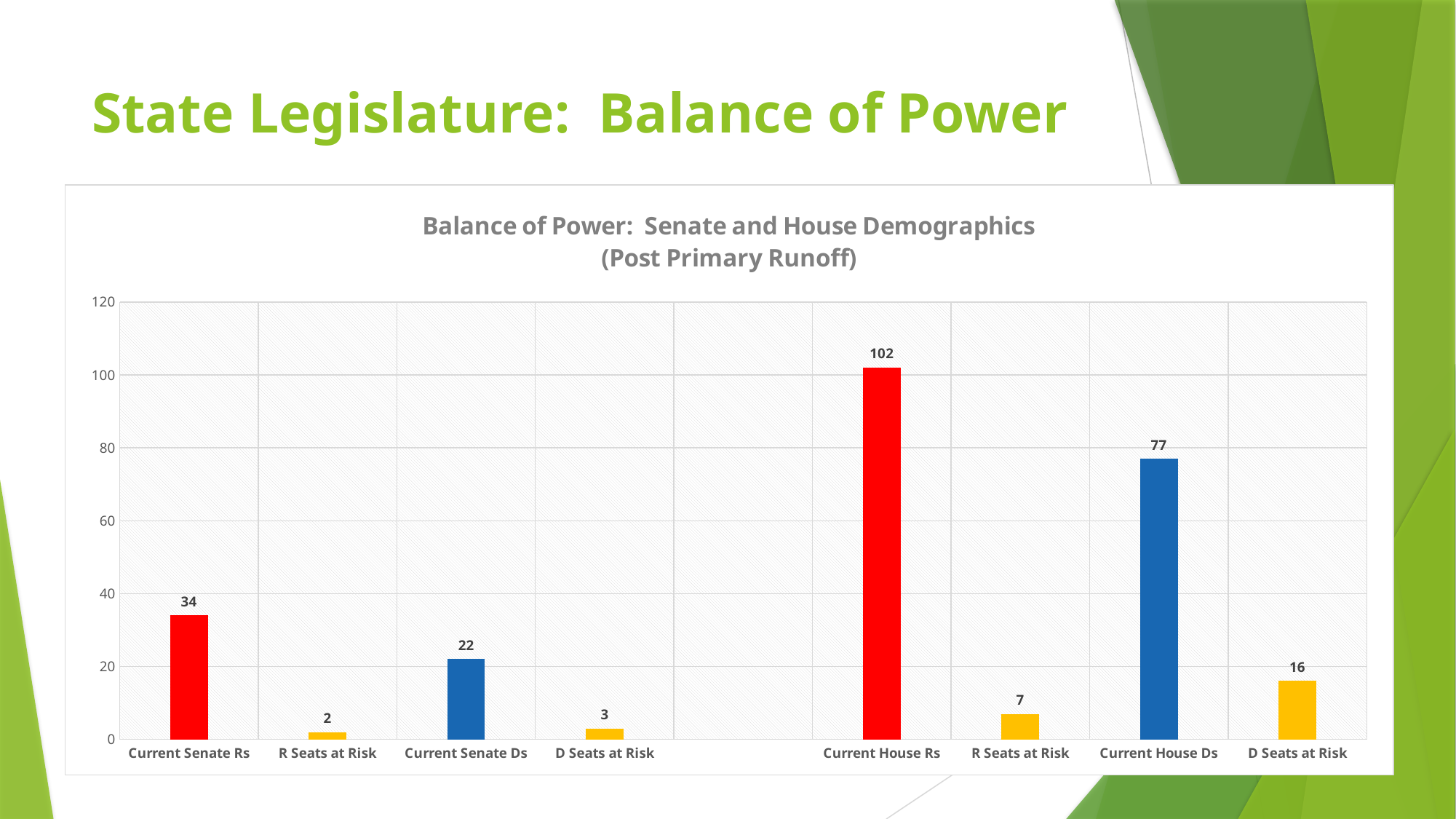
What is the difference between Current House Rs and Current House Ds? 25 What type of chart is shown on the slide? Bar chart Which is larger, the R Seats at Risk bar on the House side or the D Seats at Risk bar on the House side? D Seats at Risk (House side) What is the value for Current Senate Rs? 34 What is the value for Current House Ds? 77 Which category has the highest value? Current House Rs Which category has the lowest value? R Seats at Risk (Senate side) How many bars are plotted in the chart? 8 What is the difference between Current Senate Rs and Current Senate Ds? 12 What is the value for Current Senate Ds? 22 What is the value of the D Seats at Risk bar on the House side (rightmost bar)? 16 What is the value for Current House Rs? 102